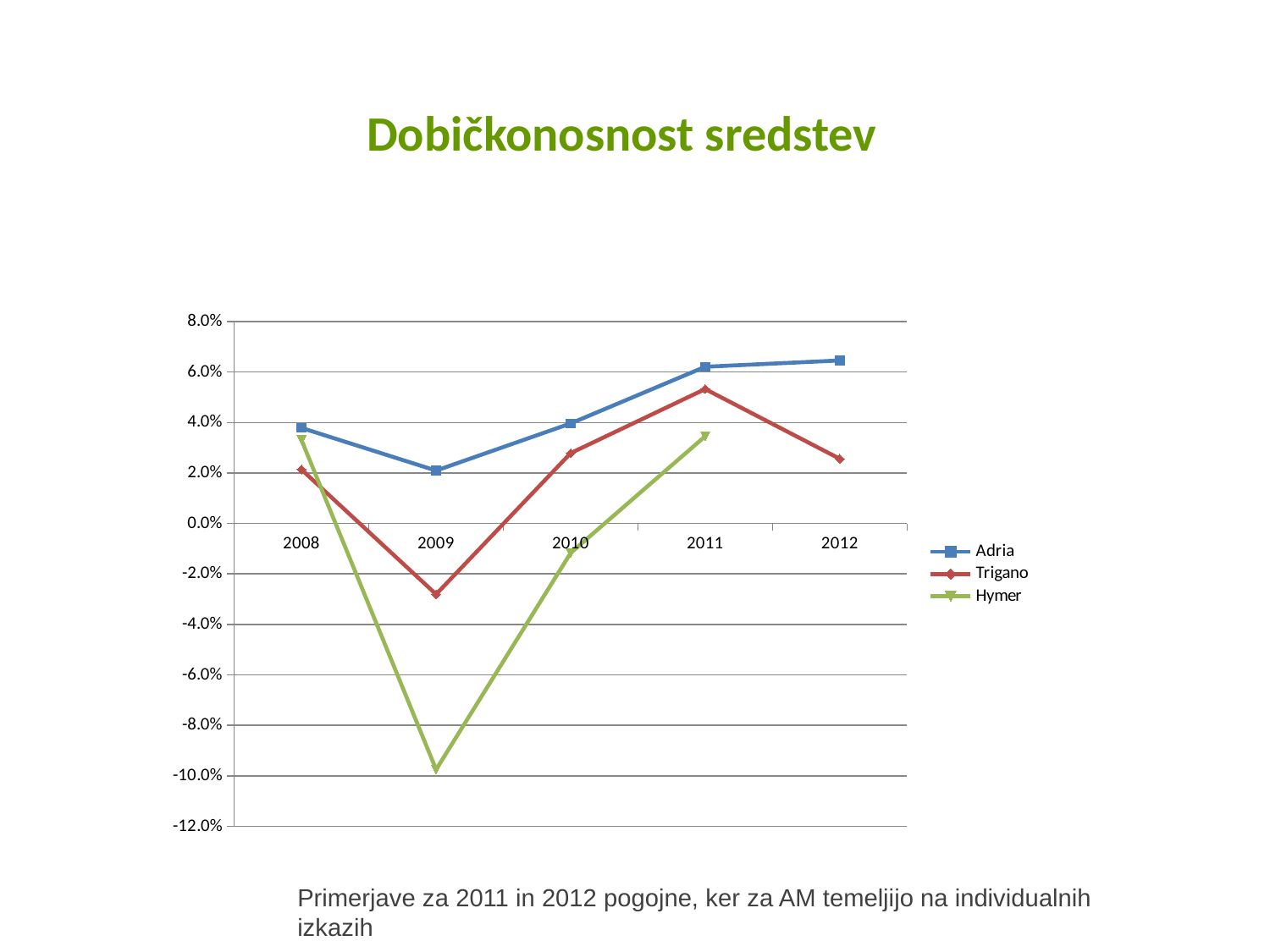
In 2012, which is larger, Adria or Trigano? Adria Is the value for Adria in 2012 greater or less than 6.0%? greater Which series has the highest value in 2011? Adria What is the title of the chart? Dobičkonosnost sredstev How many years are shown on the x axis? 5 Is the value for Hymer in 2009 greater or less than -8.0%? less How many series does the legend list? 3 Is the value for Trigano in 2009 greater or less than 0.0%? less What kind of chart is shown on the slide? line chart For Trigano, which is larger, the value in 2011 or the value in 2012? 2011 Which series has the lowest value in 2009? Hymer Does the Adria line rise or fall from 2009 to 2012? rises